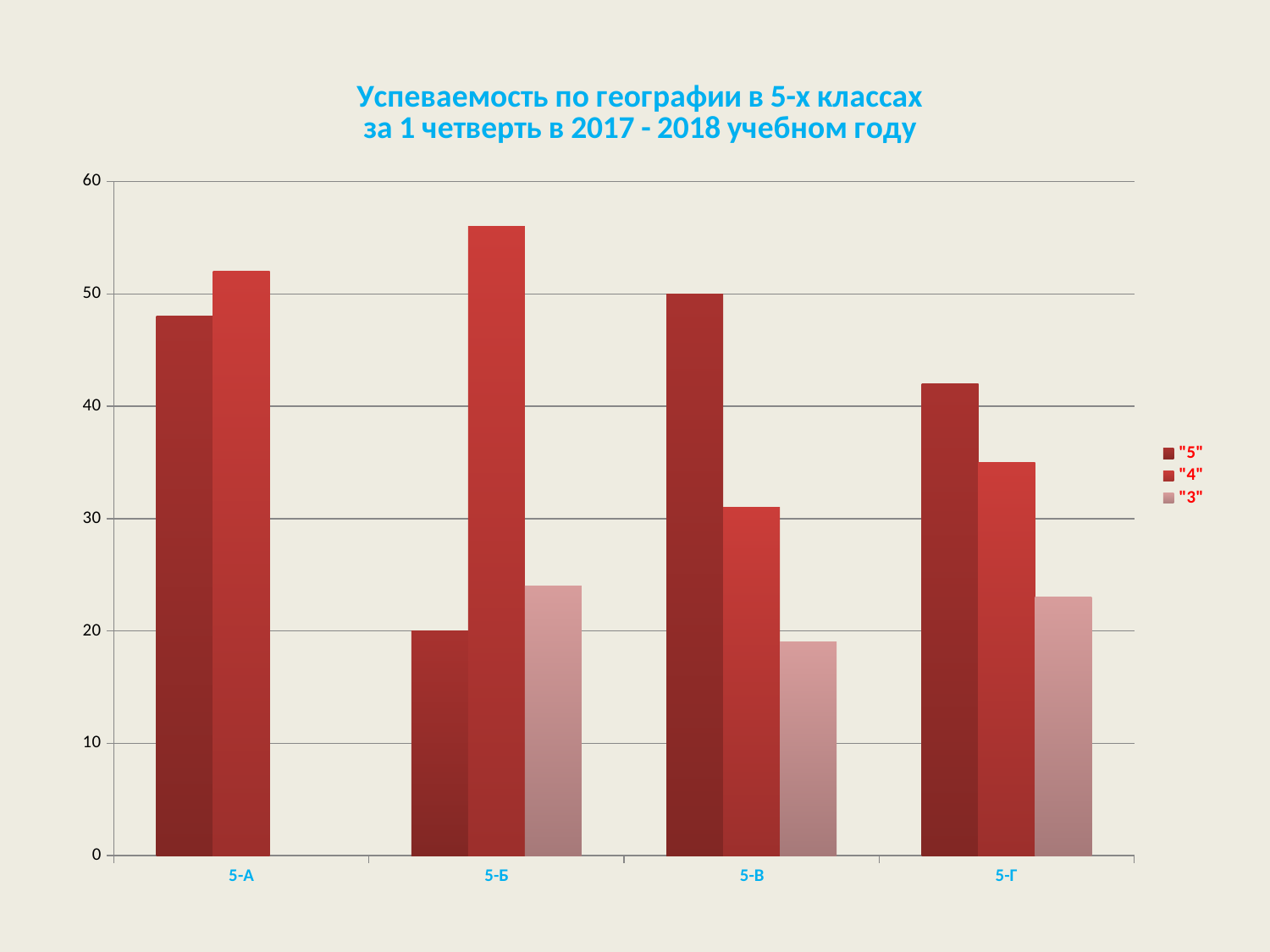
Which class has the highest value for the "4" series? 5-Б What is the value of the "5" series for class 5-В? 50 What is the title of the chart? Успеваемость по географии в 5-х классах за 1 четверть в 2017 - 2018 учебном году How many series does the legend list? 3 Is the value of the "3" series for class 5-В greater or less than 20? less For class 5-В, which is larger: the "5" series or the "4" series? "5" What is the value of the "5" series for class 5-Б? 20 Is the value of the "5" series for class 5-Г greater or less than 40? greater What kind of chart is shown on the slide? bar chart How many classes are shown on the x axis? 4 Which class has the lowest value for the "5" series? 5-Б Is the value of the "4" series for class 5-А greater or less than 50? greater